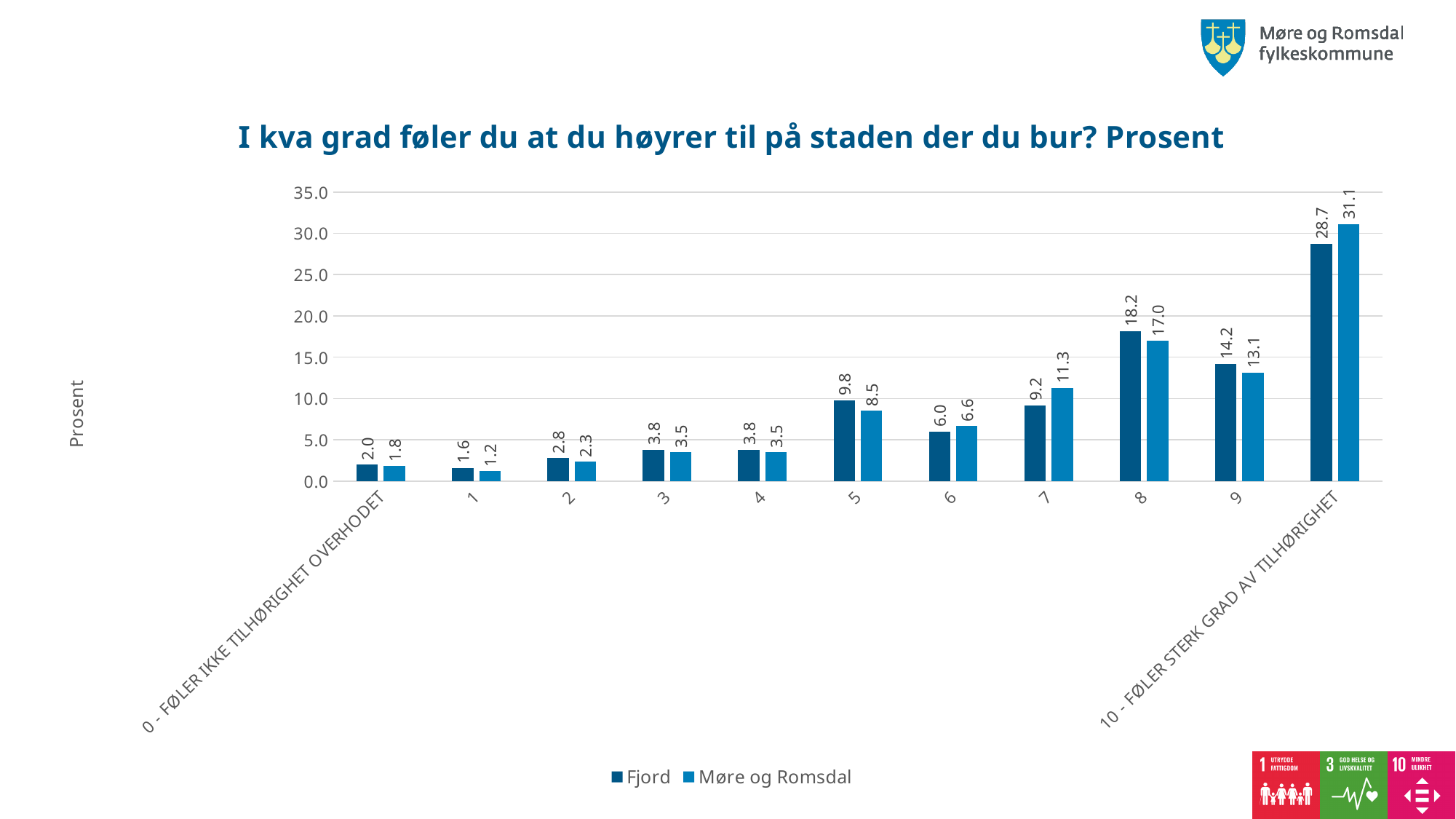
Which category has the lowest value for Fjord? 1 What is the value for Møre og Romsdal at category 8? 17.0 How many categories are shown on the x axis? 11 What is the value for Fjord at category '10 - Føler sterk grad av tilhørighet'? 28.7 Which series has the larger value at category 7, Fjord or Møre og Romsdal? Møre og Romsdal What is the difference between Møre og Romsdal and Fjord at category 10 - Føler sterk grad av tilhørighet? 2.4 What is the value for Fjord at category 5? 9.8 Is the value for Fjord at category 8 greater or less than 15.0? greater What kind of chart is shown on the slide? Bar chart What is the title of the chart? I kva grad føler du at du høyrer til på staden der du bur? Prosent How many series does the legend list? 2 Which category has the highest value for Møre og Romsdal? 10 - Føler sterk grad av tilhørighet